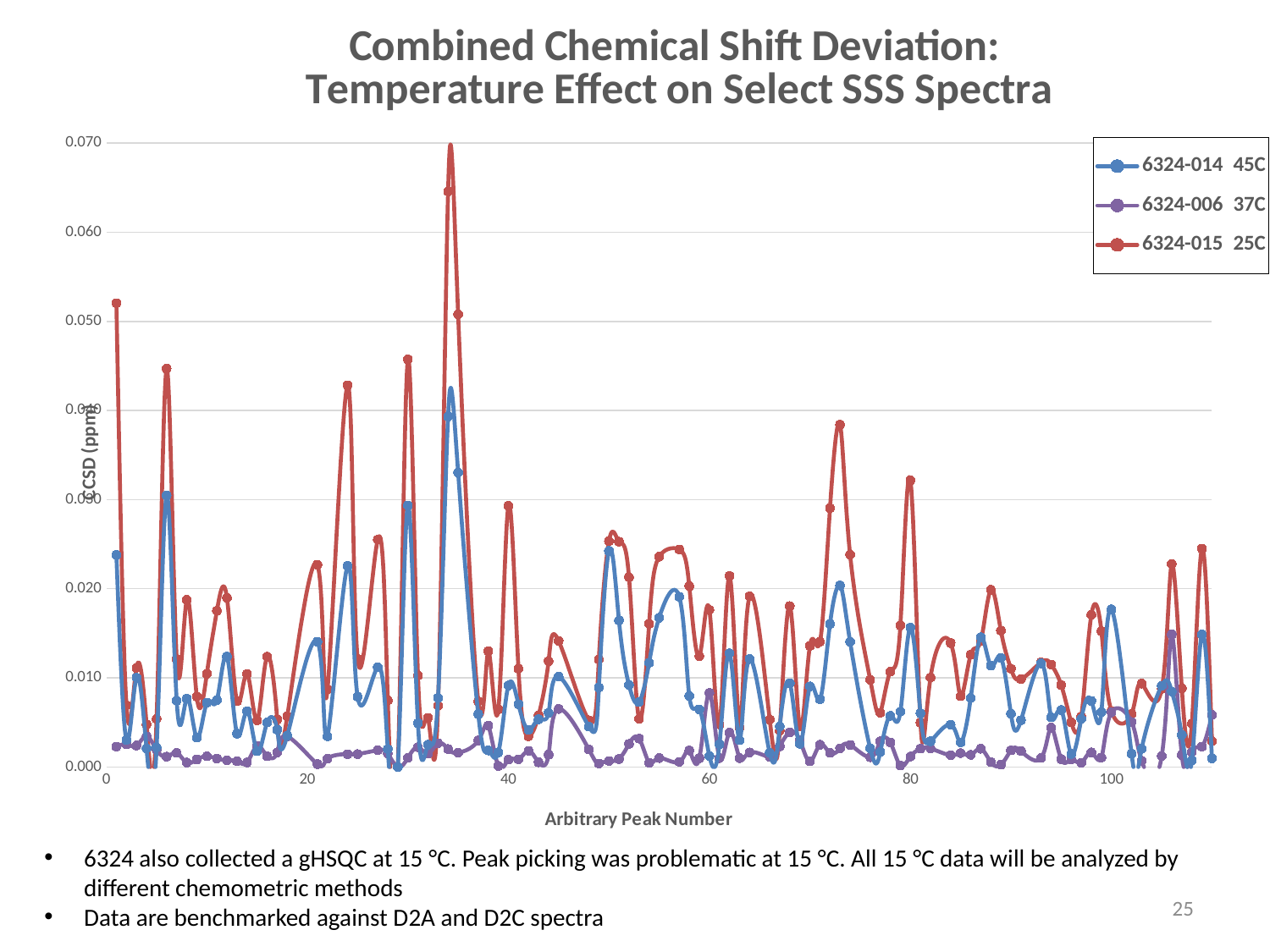
What is the title of the chart? Combined Chemical Shift Deviation: Temperature Effect on Select SSS Spectra What kind of chart is shown on the slide? line chart Which series stays lowest across most of the chart? 6324-006 37C Is the highest value of the 6324-015 25C series greater or less than 0.060? greater Around peak number 34, which series has the larger value, 6324-015 25C or 6324-006 37C? 6324-015 25C Which series reaches the highest value anywhere on the chart? 6324-015 25C Is the value of the 6324-015 25C series at peak number 1 greater or less than 0.040? greater How many series does the legend list? 3 Is the highest value of the 6324-014 45C series greater or less than 0.030? greater What is the highest tick value shown on the y axis? 0.070 What is the label of the x axis? Arbitrary Peak Number